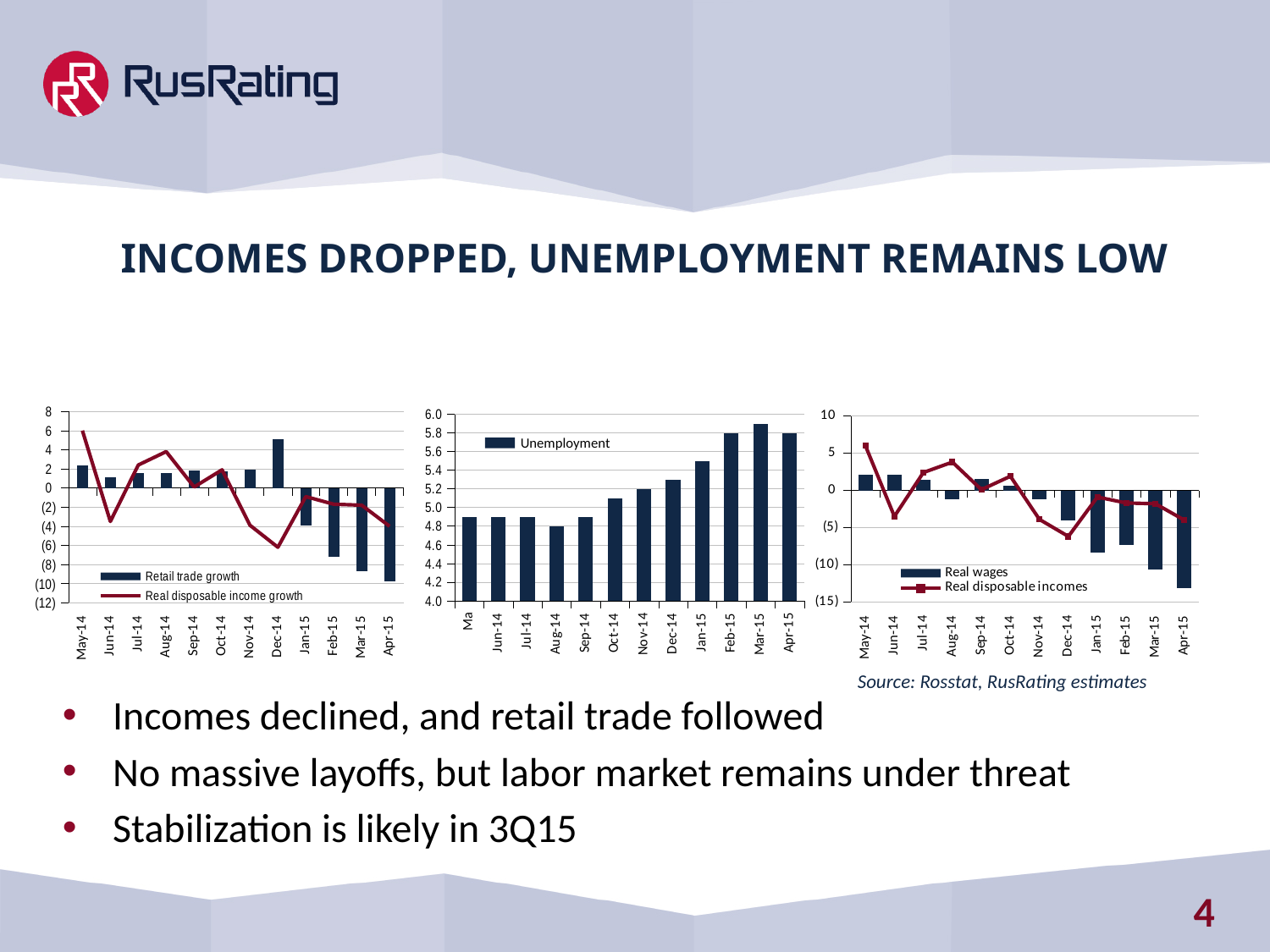
In the middle chart, which month has the highest unemployment? Mar-15 In the middle chart, is the unemployment value for Mar-15 greater or less than 5.6? greater In the middle chart, is the unemployment value for Aug-14 greater or less than 5.0? less In the left chart, which month has the lowest retail trade growth bar? Apr-15 In the middle chart, does unemployment generally rise or fall from May-14 to Apr-15? rise In the left chart, is the retail trade growth value for Dec-14 greater or less than 4? greater What kind of chart is the middle chart showing unemployment? bar chart How many series does the legend of the right chart list? 2 In the middle chart, which month has the lowest unemployment? Aug-14 In the right chart, which month has the lowest real wages bar? Apr-15 In the left chart, which month has the highest retail trade growth bar? Dec-14